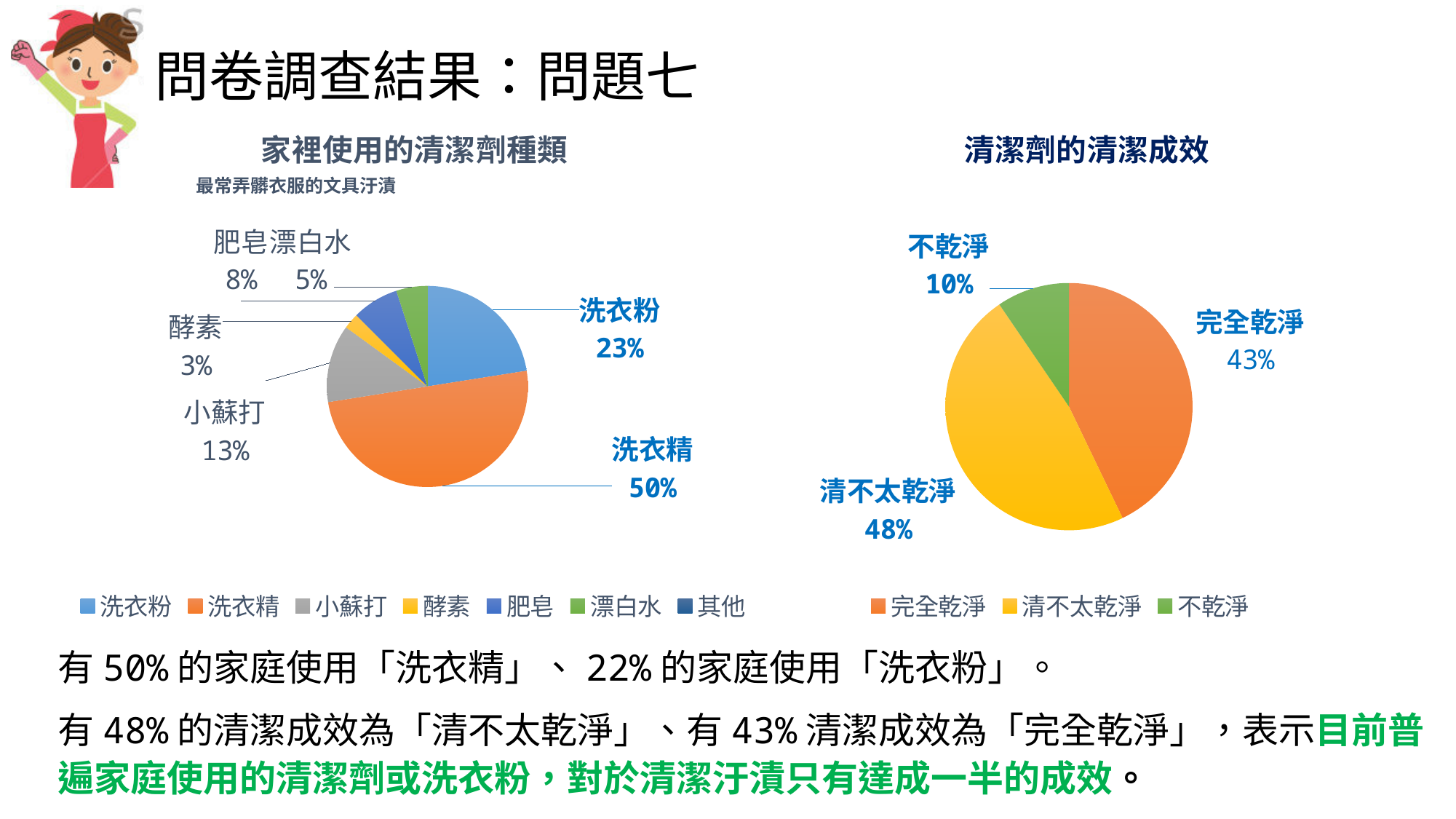
In the chart titled 家裡使用的清潔劑種類, which labelled category has the smallest slice? 酵素 How many entries does the legend of the chart titled 家裡使用的清潔劑種類 list? 7 In the chart titled 家裡使用的清潔劑種類, what is the difference between the percentages for 洗衣精 and 洗衣粉? 27% In the chart titled 清潔劑的清潔成效, which category has the largest share? 清不太乾淨 What type of chart is the chart titled 清潔劑的清潔成效? Pie chart In the chart titled 家裡使用的清潔劑種類, which is larger, 肥皂 or 漂白水? 肥皂 In the chart titled 清潔劑的清潔成效, what percentage is shown for 完全乾淨? 43% How many categories does the chart titled 清潔劑的清潔成效 show? 3 In the chart titled 家裡使用的清潔劑種類, what percentage is shown for 小蘇打? 13% In the chart titled 家裡使用的清潔劑種類, what percentage is shown for 洗衣精? 50% In the chart titled 家裡使用的清潔劑種類, which category has the largest slice? 洗衣精 In the chart titled 清潔劑的清潔成效, what is the difference between the percentages for 清不太乾淨 and 不乾淨? 38%